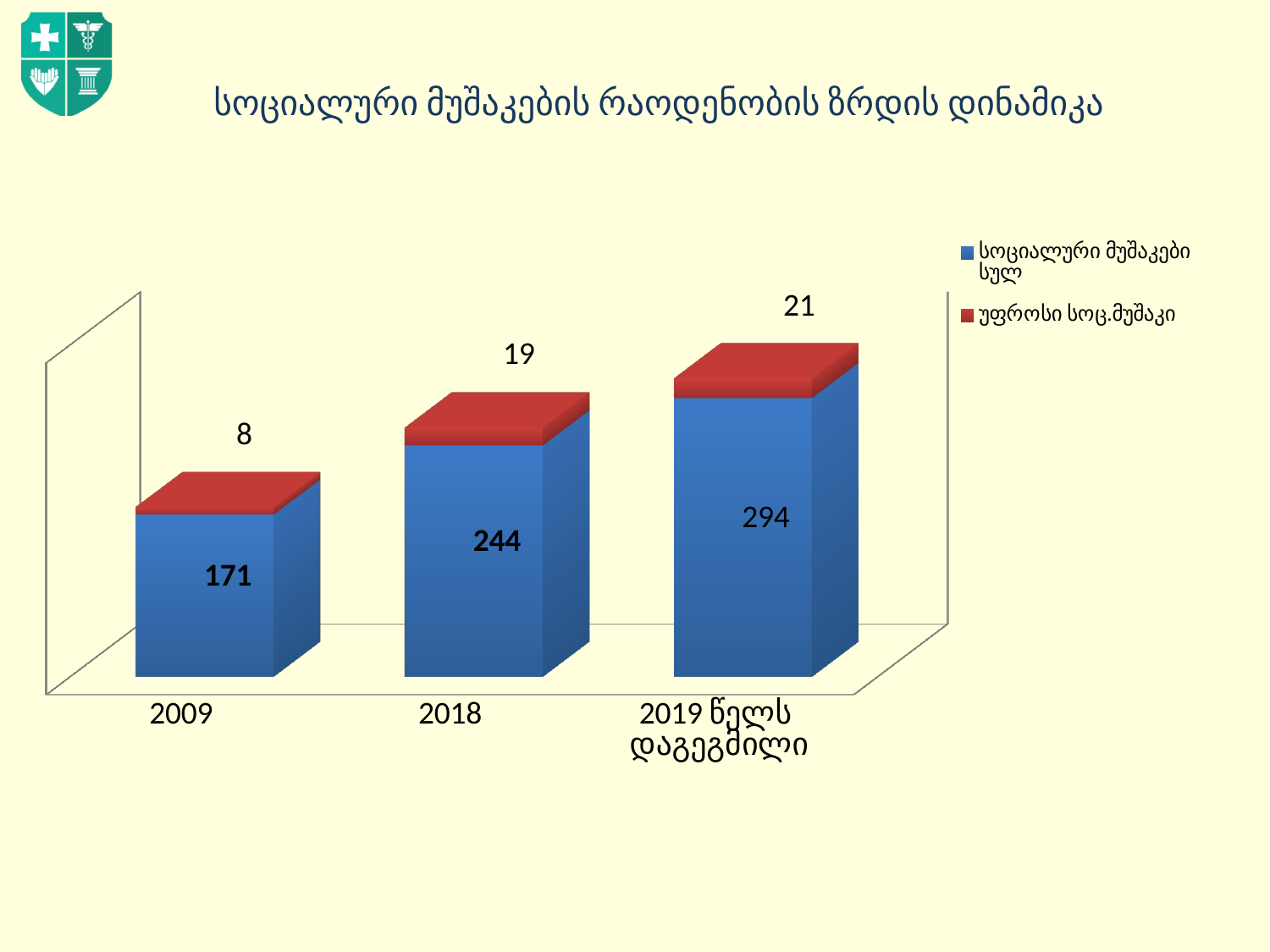
What is the value of the red series (უფროსი სოც.მუშაკი) for 2009? 8 What is the value of the blue series (სოციალური მუშაკები სულ) for 2019 წელს დაგეგმილი? 294 What is the total of the stacked bar for 2018? 263 How many categories are shown on the x axis? 3 How many series does the legend list? 2 What kind of chart is shown on the slide? Stacked bar chart What is the value of the blue series (სოციალური მუშაკები სულ) for 2009? 171 Which is larger: the red series value for 2018 or for 2019 წელს დაგეგმილი? 2019 წელს დაგეგმილი What is the value of the red series (უფროსი სოც.მუშაკი) for 2018? 19 Which category has the highest value for the blue series (სოციალური მუშაკები სულ)? 2019 წელს დაგეგმილი What is the difference between the blue series values for 2018 and 2009? 73 Which category has the lowest value for the red series (უფროსი სოც.მუშაკი)? 2009